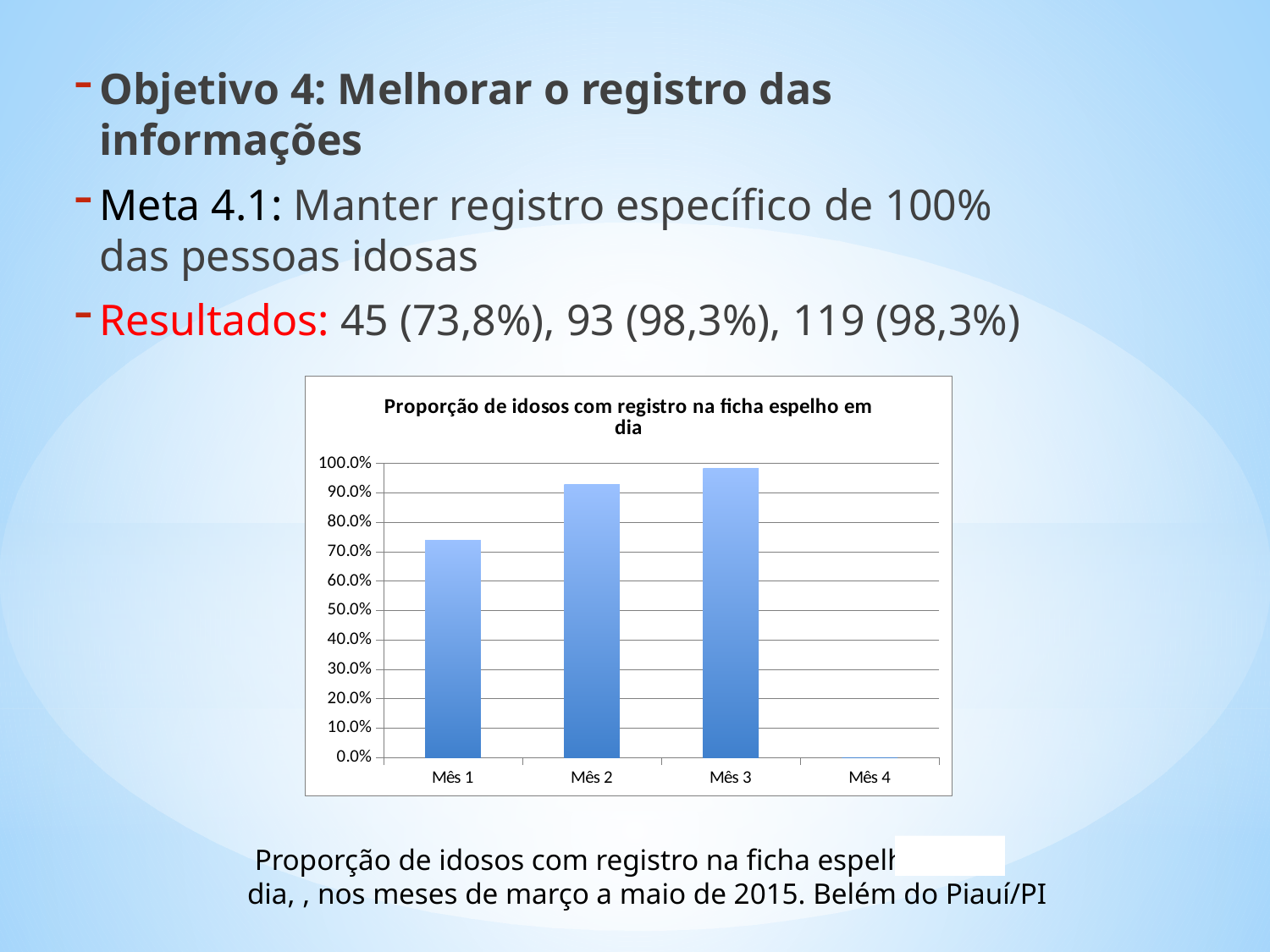
Among the months with a plotted bar, which has the lowest value? Mês 1 Is the value for Mês 1 greater or less than 70.0%? greater What is the title of the chart? Proporção de idosos com registro na ficha espelho em dia Is the value for Mês 3 greater or less than 100.0%? less How many bars are actually plotted in the chart? 3 Which month has the highest bar in the chart? Mês 3 Which is larger, the value for Mês 1 or the value for Mês 2? Mês 2 Is the value for Mês 1 greater or less than 80.0%? less What kind of chart is shown on the slide? bar chart Do the bar values rise or fall from Mês 1 to Mês 3? rise How many categories are labelled on the x axis of the chart? 4